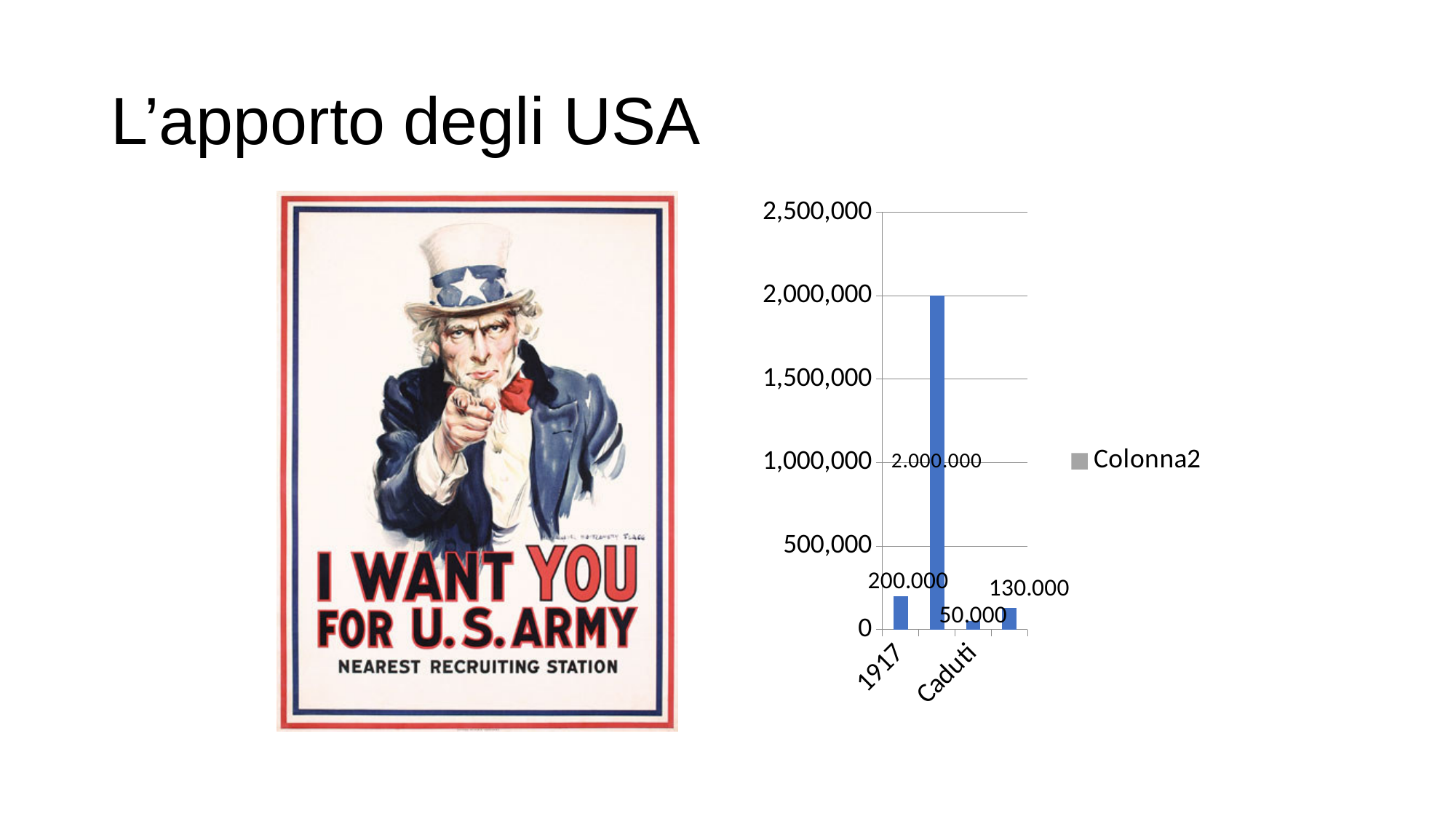
What is the value of the bar for Caduti? 50.000 What is the value of the rightmost bar in the chart? 130.000 What is the value of the tallest bar in the chart? 2.000.000 Is the value for 1917 greater or less than 500,000? less How many series does the legend list? 1 What is the difference between the value for 1917 and the value for Caduti? 150.000 Which is larger, the value for 1917 or the value for Caduti? 1917 Which labelled category has the lowest value, 1917 or Caduti? Caduti How many bars are plotted in the chart? 4 What is the value of the bar for 1917? 200.000 What kind of chart is shown on the slide? bar chart Is the value of the tallest bar greater or less than 1,500,000? greater